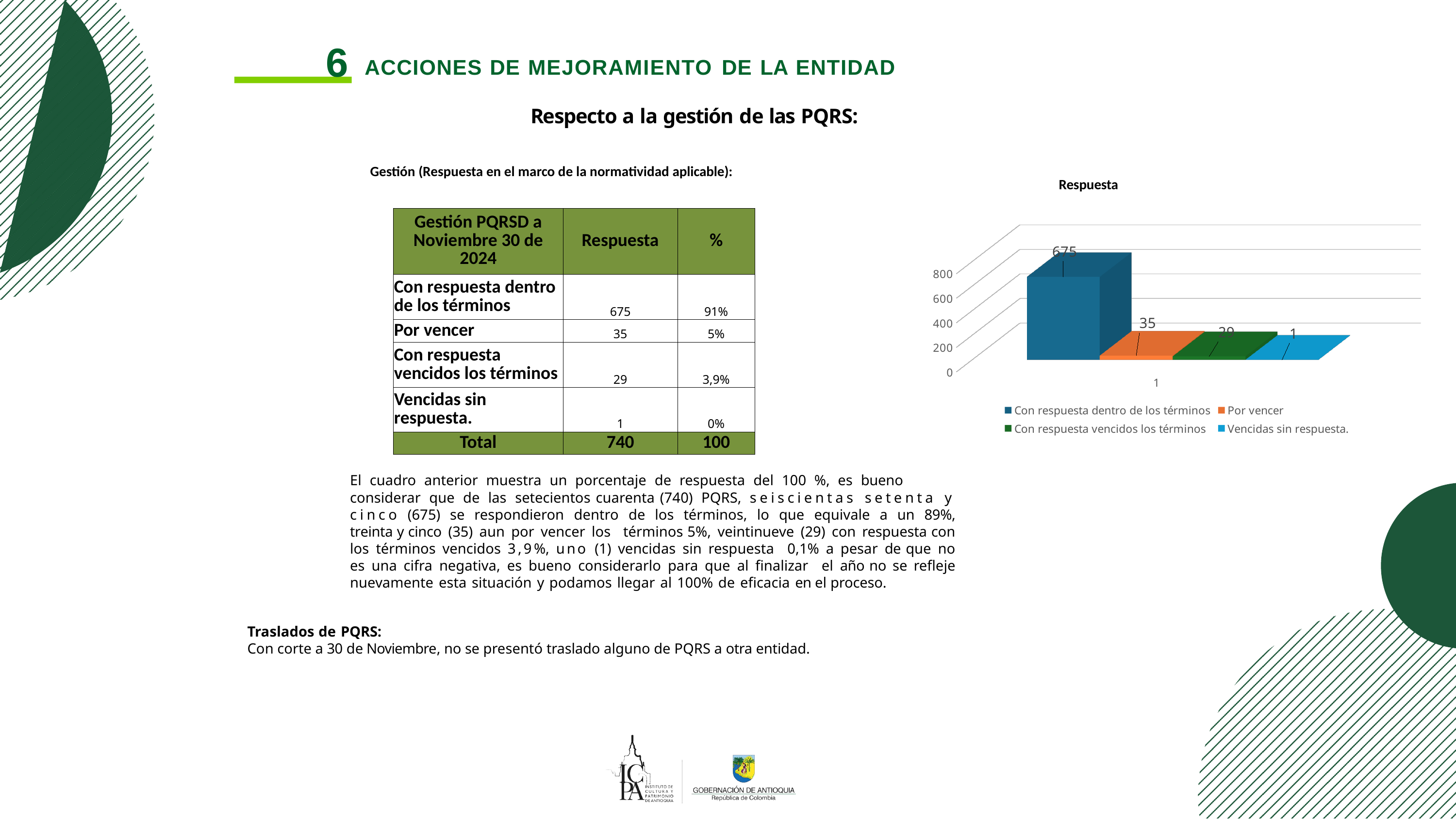
What type of chart is shown on the slide? bar chart What is the value for 'Por vencer' in the chart? 35 Which series has the highest value in the chart? Con respuesta dentro de los términos How many series does the chart legend list? 4 What is the value for 'Con respuesta vencidos los términos' in the chart? 29 Is the value for 'Con respuesta dentro de los términos' greater or less than 600? greater Which series has the lowest value in the chart? Vencidas sin respuesta. What is the difference between the values for 'Con respuesta dentro de los términos' and 'Por vencer'? 640 What is the value for 'Vencidas sin respuesta.' in the chart? 1 What is the title of the chart? Respuesta What is the value for 'Con respuesta dentro de los términos' in the chart? 675 Which is larger, the value for 'Por vencer' or the value for 'Con respuesta vencidos los términos'? Por vencer